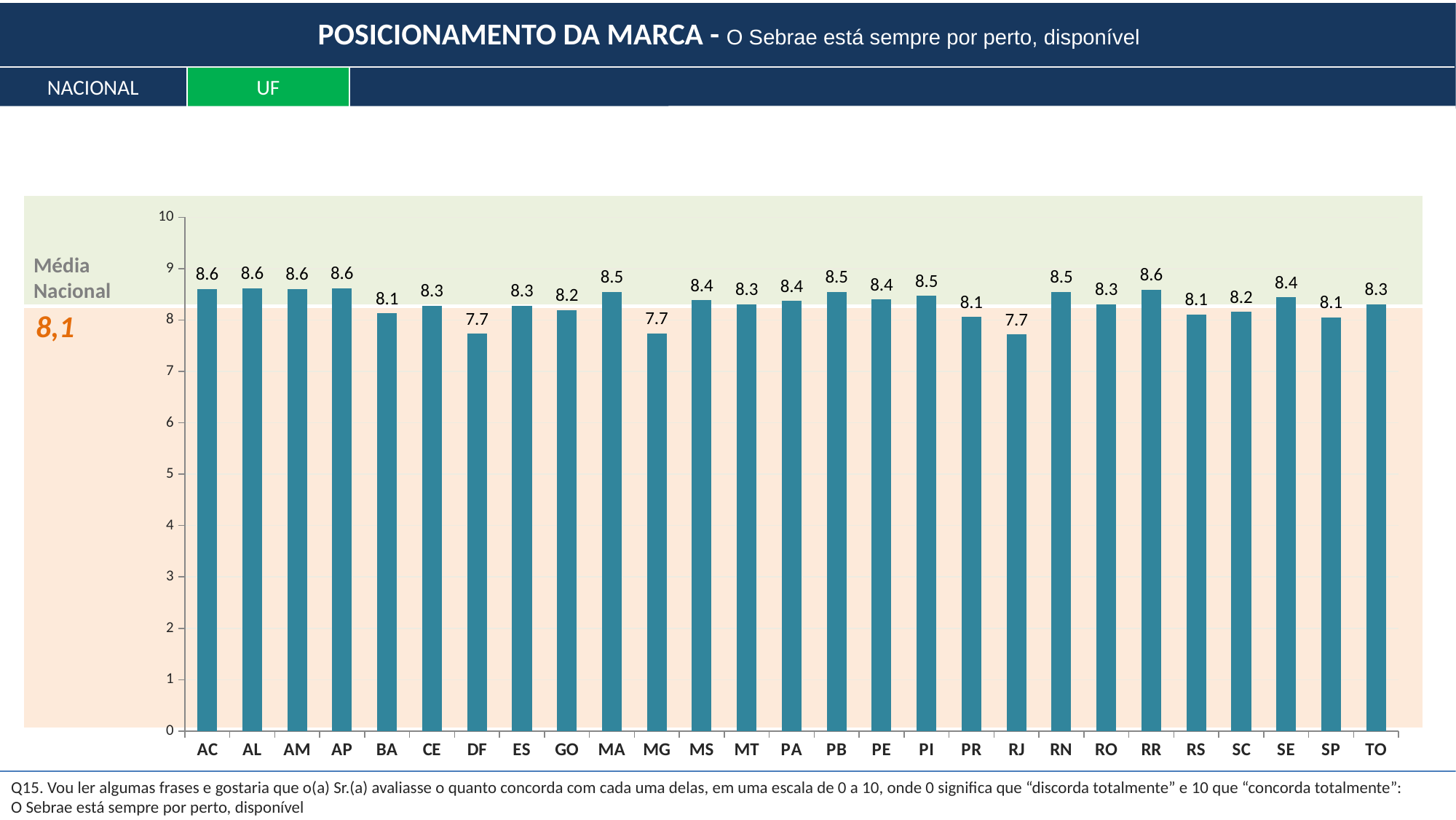
What is the value for RR? 8.6 Is the value for MG greater or less than 8? less What is the difference between the values for AC and RJ? 0.9 What is the value for MA? 8.5 What is the value for DF? 7.7 Which has a larger value, PB or GO? PB What is the Média Nacional value shown on the slide? 8,1 What is the lowest value shown among the states? 7.7 What is the highest value shown among the states? 8.6 How many states (categories) are shown on the x axis? 27 What is the value for SP? 8.1 What kind of chart is shown on the slide? bar chart